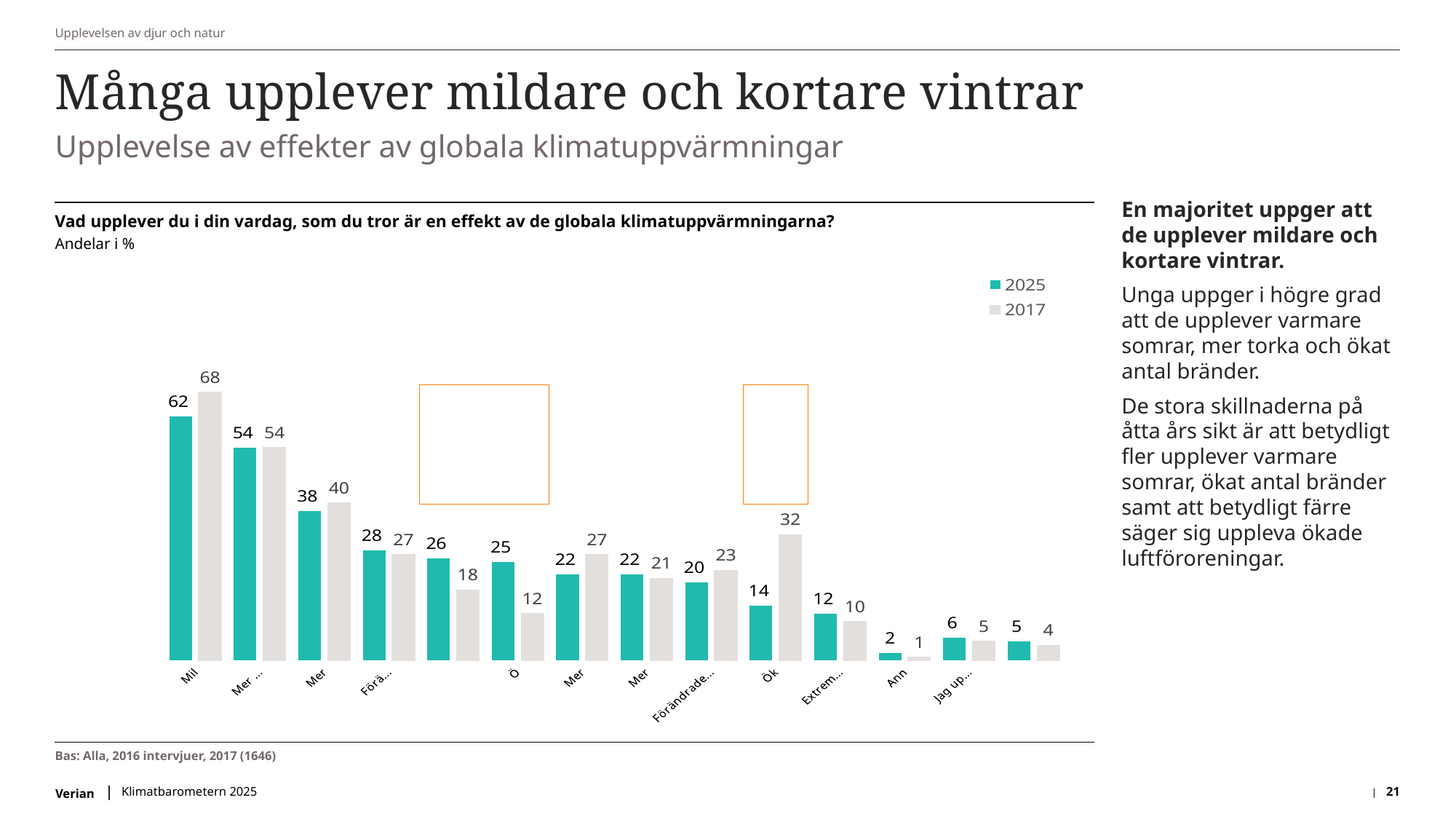
What is the highest value in the 2025 series? 62 What is the difference between the 2017 and 2025 values for the first (leftmost) category? 6 Which two years are listed in the chart legend? 2025 and 2017 What is the lowest value in the 2025 series? 2 What kind of chart is shown on the slide? Bar chart For the category labelled 'Ök', which series has the larger value, 2025 or 2017? 2017 What is the 2025 value for the last (rightmost) category? 5 What is the highest value in the 2017 series? 68 What is the lowest value in the 2017 series? 1 For the category labelled 'Ök', what is the difference between the 2017 value and the 2025 value? 18 How many series does the legend list? 2 What is the 2017 value for the first (leftmost) category? 68